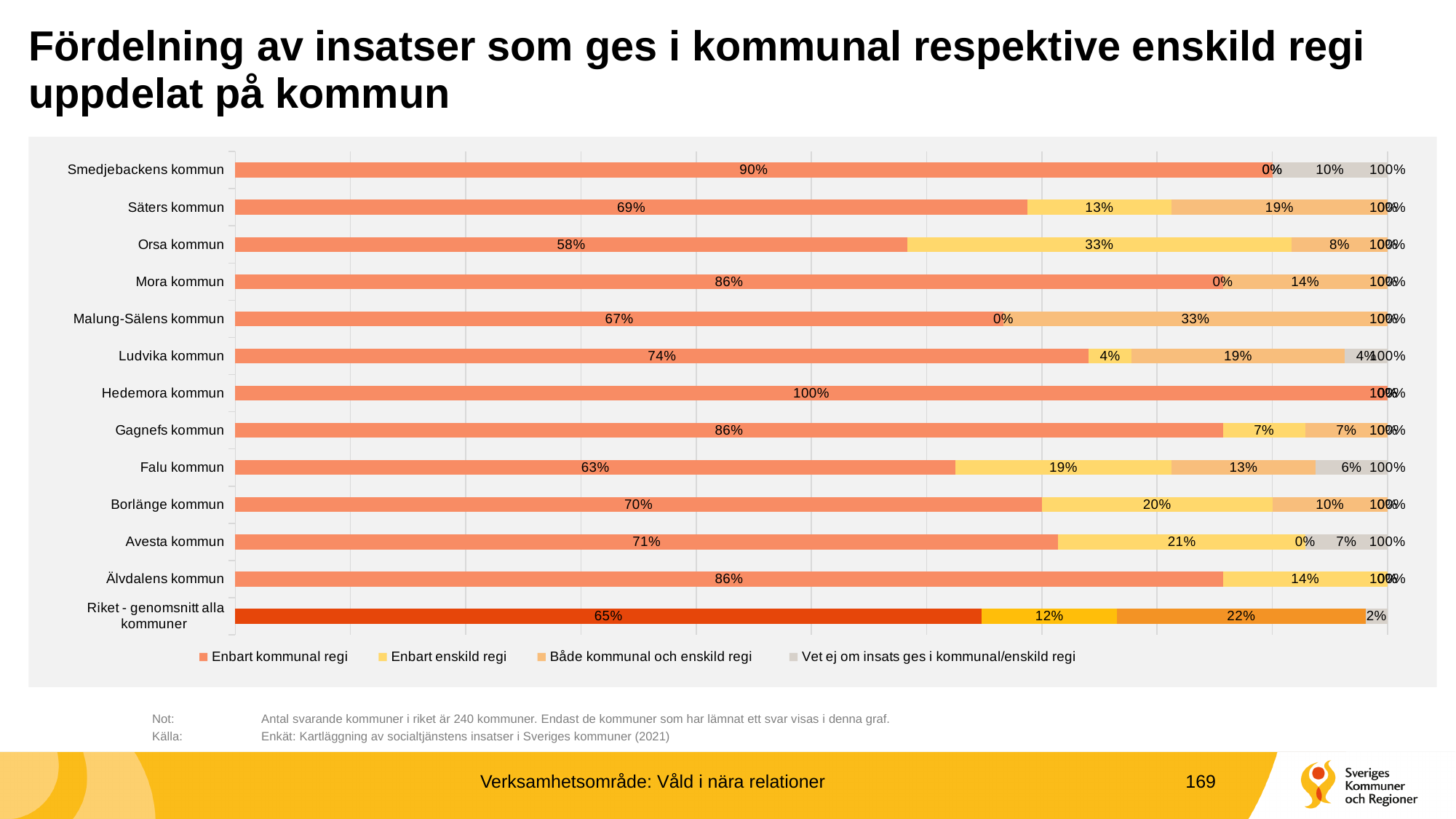
Which kommun has the highest value for 'Enbart kommunal regi'? Hedemora kommun Which kommun has the lowest value for 'Enbart kommunal regi'? Orsa kommun How many categories (rows) are plotted in the chart? 13 Which has a larger 'Enbart enskild regi' value, Orsa kommun or Säters kommun? Orsa kommun What is the value of 'Enbart enskild regi' for Borlänge kommun? 20% What is the difference between the 'Enbart kommunal regi' values for Smedjebackens kommun and Falu kommun? 27% What is the value of 'Vet ej om insats ges i kommunal/enskild regi' for Smedjebackens kommun? 10% What is the 'Enbart kommunal regi' value for 'Riket - genomsnitt alla kommuner'? 65% What kind of chart is shown on the slide? Stacked bar chart How many series does the legend list? 4 What is the value of 'Både kommunal och enskild regi' for Malung-Sälens kommun? 33% What is the value of 'Enbart kommunal regi' for Orsa kommun? 58%